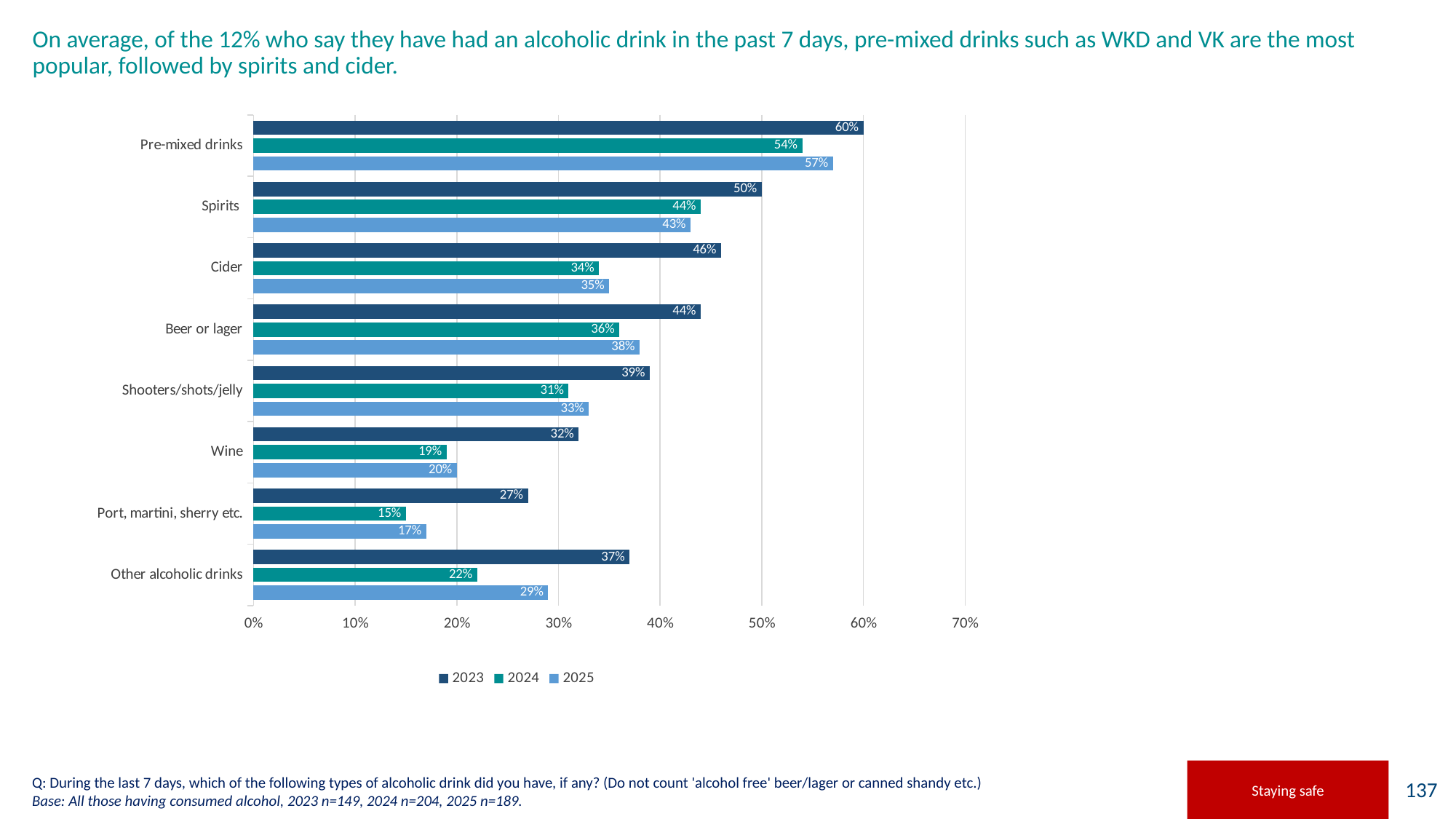
Which is larger for Beer or lager: the 2024 value or the 2025 value? 2025 What is the value for Port, martini, sherry etc. in 2024? 15% Which category has the lowest value in 2025? Port, martini, sherry etc. What is the value for Wine in 2023? 32% What is the difference between the 2023 and 2024 values for Cider? 12 percentage points Is the value for Other alcoholic drinks in 2023 greater or less than 30%? greater How many series does the legend list? 3 Which years are listed in the legend? 2023, 2024, 2025 Which category has the highest value in 2023? Pre-mixed drinks What kind of chart is shown on the slide? Bar chart How many drink categories are shown on the chart? 8 What is the value for Pre-mixed drinks in 2025? 57%